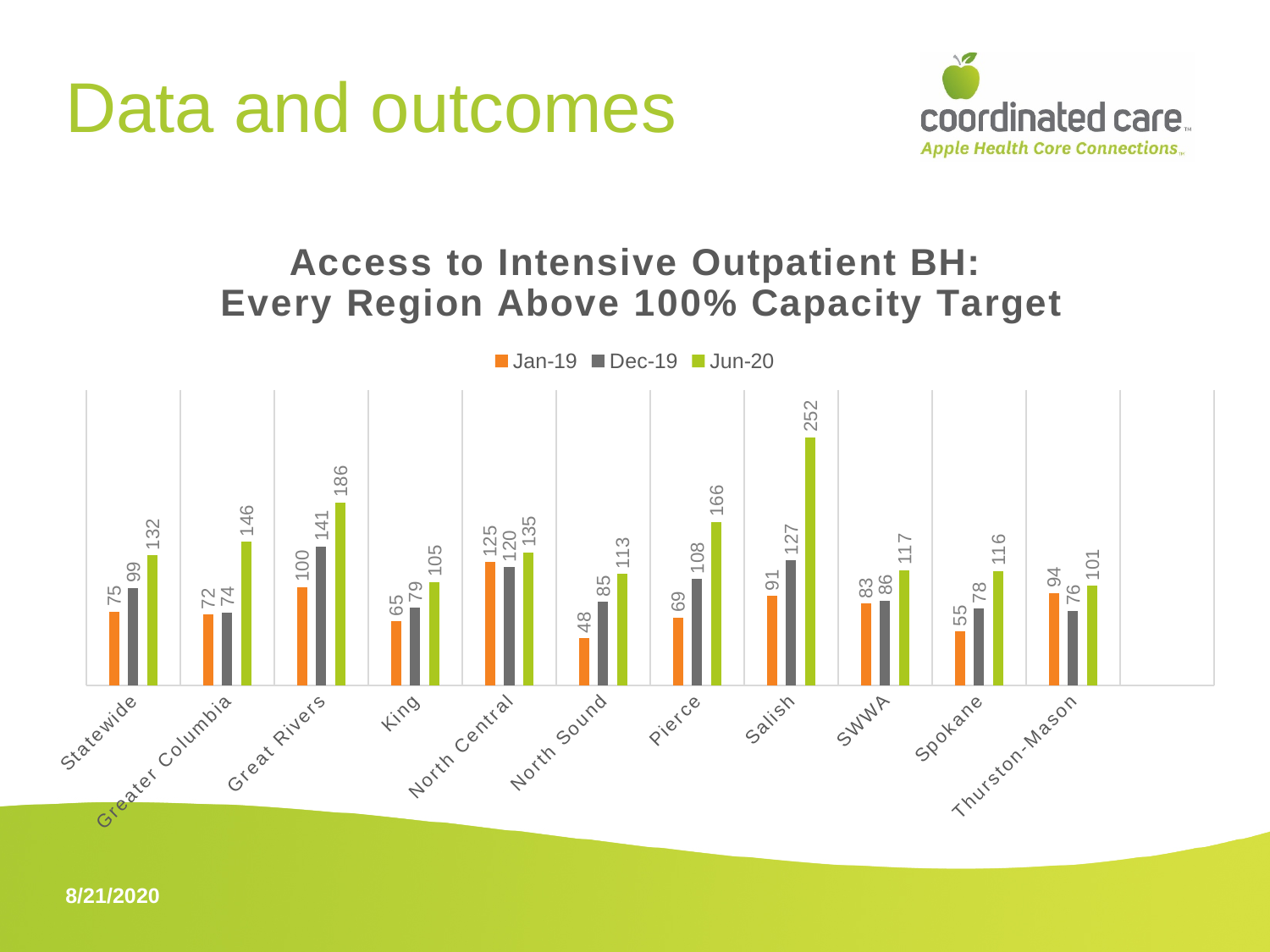
What is the Jun-20 value for Salish? 252 What is the Jan-19 value for North Sound? 48 What is the Dec-19 value for Great Rivers? 141 How many regions (categories) are shown on the x axis? 11 Which is larger for Thurston-Mason: the Jan-19 value or the Dec-19 value? Jan-19 How many series does the legend list? 3 What kind of chart is shown on the slide? Bar chart What is the difference between the Jun-20 and Jan-19 values for Pierce? 97 Which region has the highest Jun-20 value? Salish Which region has the lowest Jan-19 value? North Sound Do the values for Spokane rise or fall from Jan-19 to Jun-20? Rise What is the title of the chart? Access to Intensive Outpatient BH: Every Region Above 100% Capacity Target